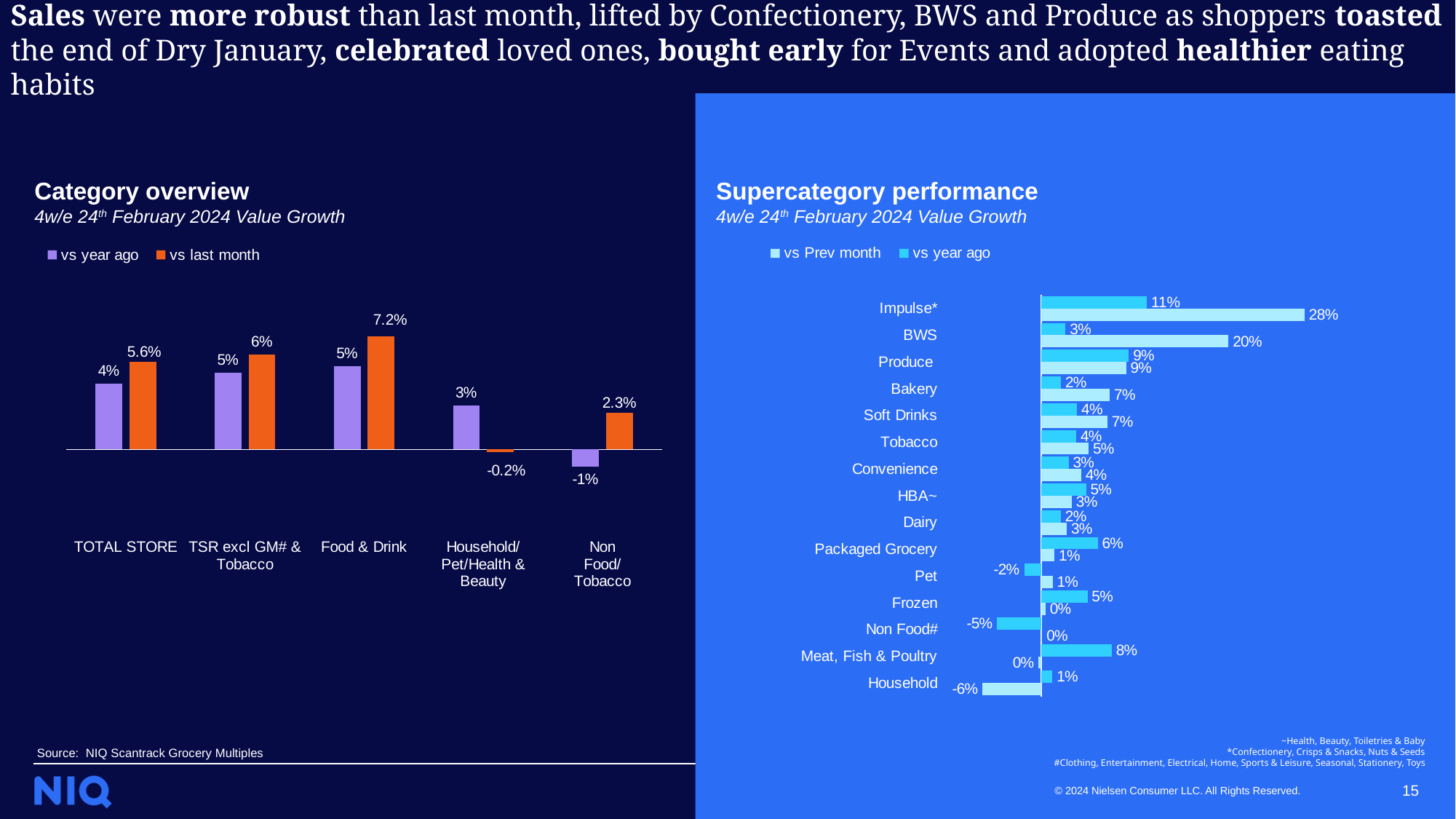
In the Category overview chart, what is the difference between the vs last month and vs year ago values for TOTAL STORE? 1.6% In the Category overview chart, what is the vs year ago value for Non Food/Tobacco? -1% In the Category overview chart, which category has the lowest vs last month value? Household/Pet/Health & Beauty In the Category overview chart, which category has the highest vs last month value? Food & Drink How many series does the legend of the Supercategory performance chart list? 2 How many supercategories are listed in the Supercategory performance chart? 15 In the Category overview chart, what is the vs last month value for Food & Drink? 7.2% In the Supercategory performance chart, which supercategory has the highest vs year ago value? Impulse* In the Supercategory performance chart, which is larger for BWS: the vs Prev month value or the vs year ago value? vs Prev month How many categories are shown in the Category overview chart? 5 In the Supercategory performance chart, what is the vs Prev month value for Household? -6% In the Supercategory performance chart, what is the vs year ago value for Impulse*? 11%